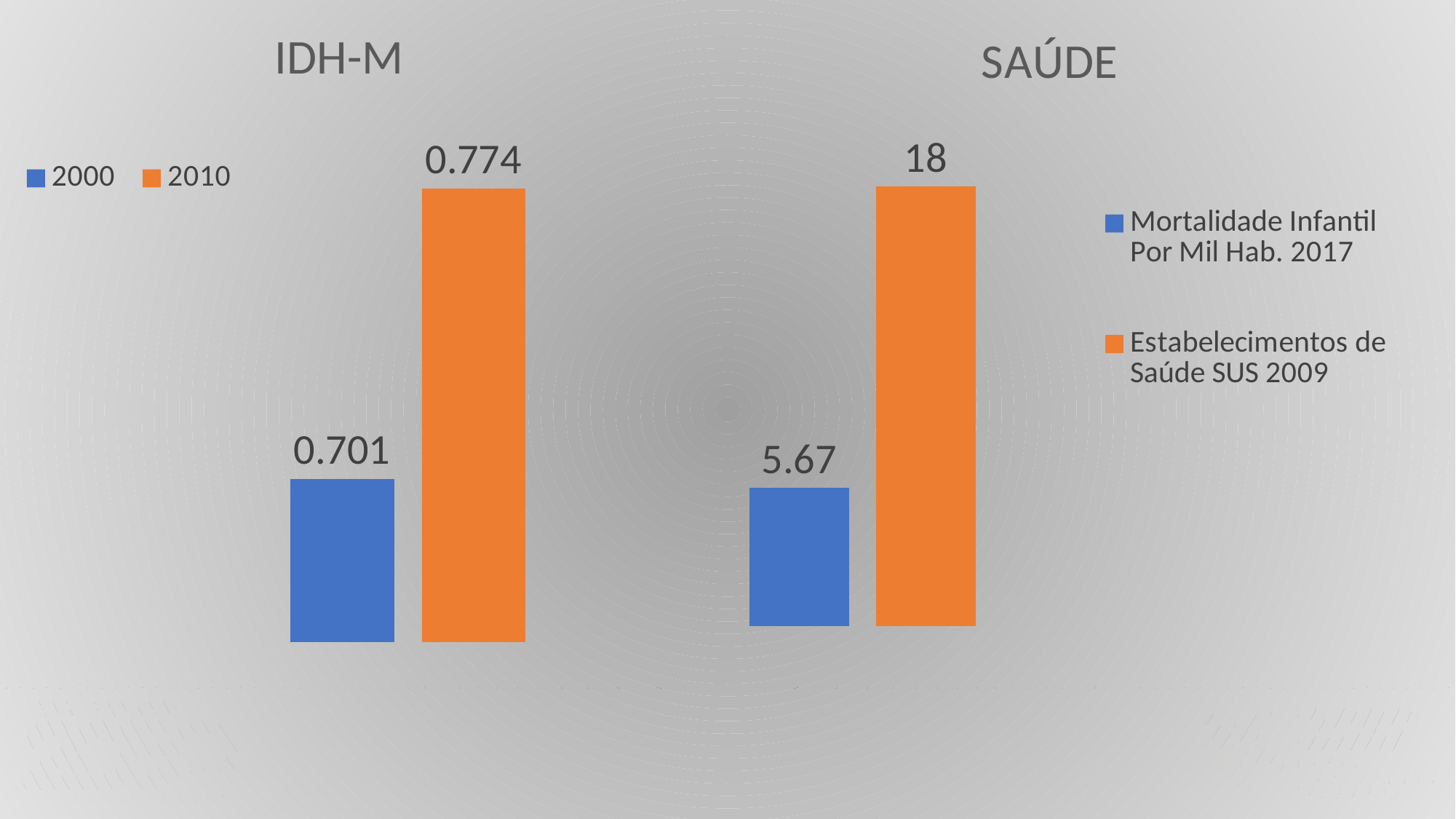
In the IDH-M chart, how many series does the legend list? 2 In the SAÚDE chart, which series has the lower value? Mortalidade Infantil Por Mil Hab. 2017 In the SAÚDE chart, what colour is the bar for Estabelecimentos de Saúde SUS 2009? Orange In the SAÚDE chart, what is the difference between Estabelecimentos de Saúde SUS 2009 and Mortalidade Infantil Por Mil Hab. 2017? 12.33 In the SAÚDE chart, what is the value for Estabelecimentos de Saúde SUS 2009? 18 What kind of chart is the SAÚDE chart? Bar chart In the IDH-M chart, what is the value for 2000? 0.701 In the IDH-M chart, which year has the higher value? 2010 In the SAÚDE chart, is the value for Estabelecimentos de Saúde SUS 2009 larger than the value for Mortalidade Infantil Por Mil Hab. 2017? Yes In the IDH-M chart, what is the difference between the 2010 and 2000 values? 0.073 In the SAÚDE chart, what is the value for Mortalidade Infantil Por Mil Hab. 2017? 5.67 In the IDH-M chart, what is the value for 2010? 0.774